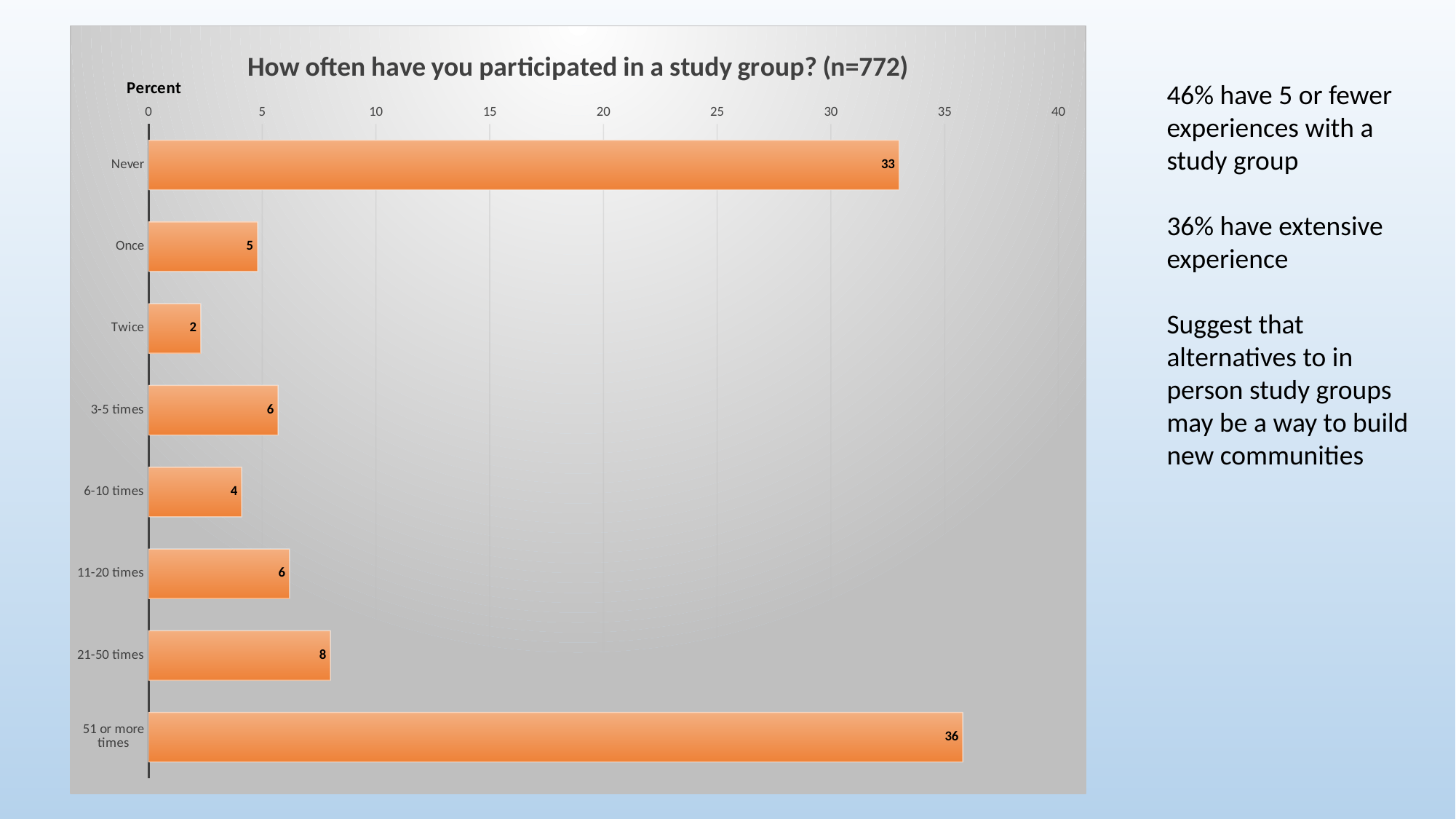
What is the title of the chart? How often have you participated in a study group? (n=772) Is the value for Never greater or less than 30? greater What is the value for 51 or more times? 36 What kind of chart is shown on the slide? bar chart What is the value for 21-50 times? 8 What is the value for Twice? 2 Which category has the lowest value? Twice What is the difference between the values for 51 or more times and Never? 3 Which category has the highest value? 51 or more times What is the value for Never? 33 Which is larger, the value for 21-50 times or the value for 6-10 times? 21-50 times How many categories are shown on the chart? 8